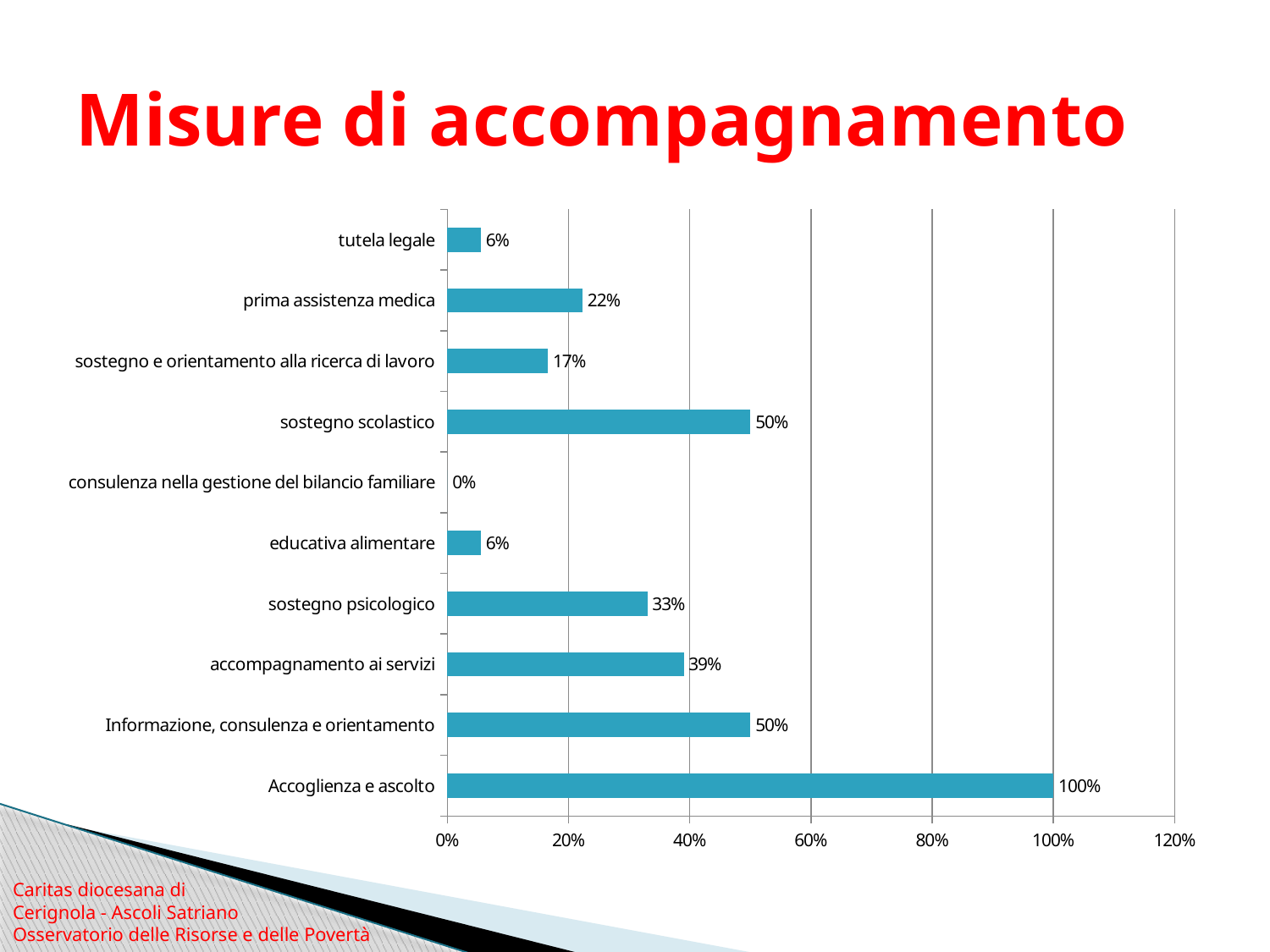
What is the highest value shown on the x axis? 120% What is the difference between the values for "accompagnamento ai servizi" and "sostegno psicologico"? 6% Which category has the lowest value? consulenza nella gestione del bilancio familiare What kind of chart is shown on the slide? Bar chart Which category has the highest value? Accoglienza e ascolto What is the value for "Accoglienza e ascolto"? 100% How many categories are shown in the chart? 10 Which is larger, the value for "prima assistenza medica" or the value for "sostegno e orientamento alla ricerca di lavoro"? prima assistenza medica What is the title of the slide? Misure di accompagnamento What is the value for "sostegno psicologico"? 33% What is the value for "prima assistenza medica"? 22% Is the value for "accompagnamento ai servizi" greater or less than 20%? greater